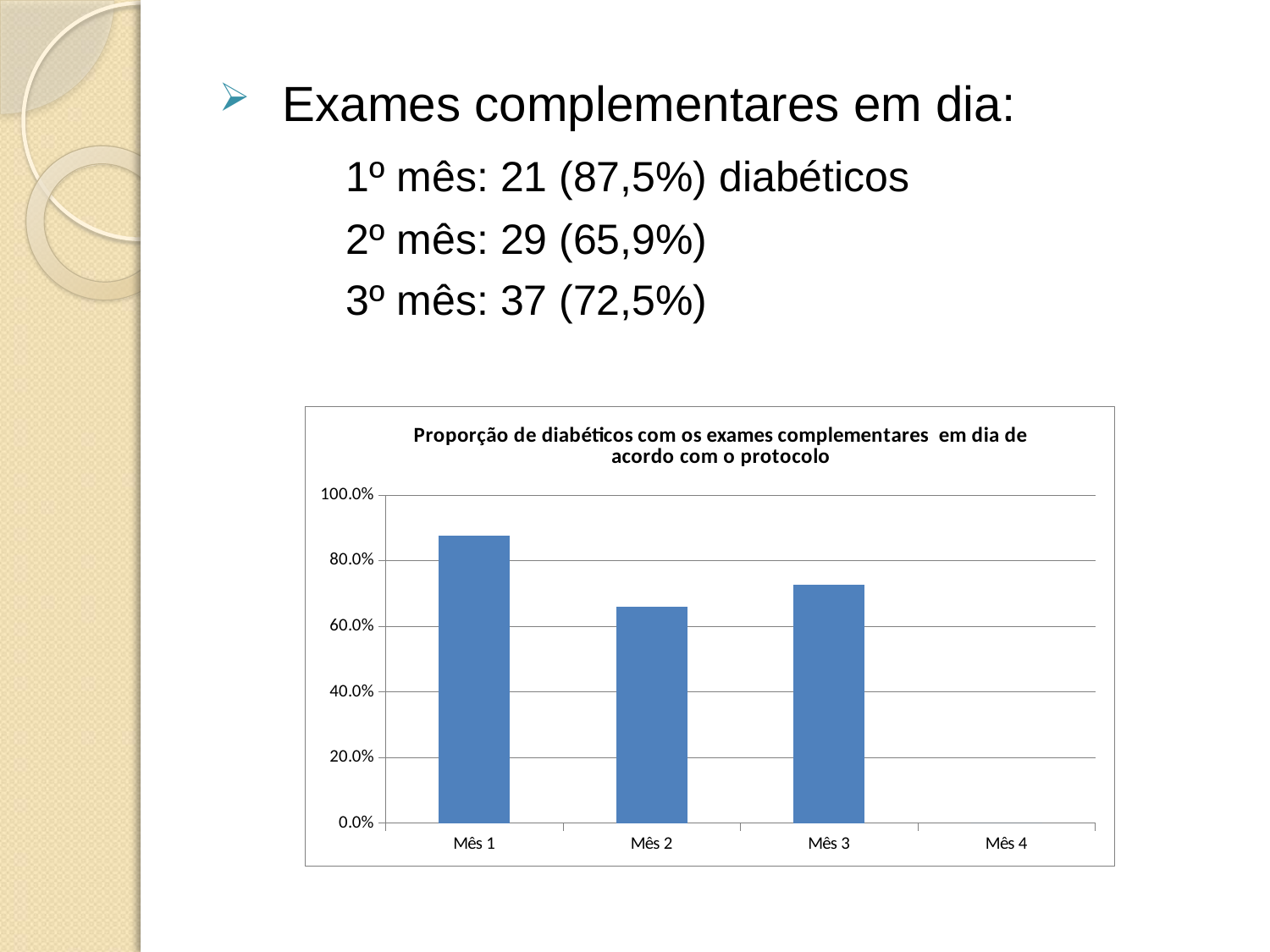
Does the value rise or fall from Mês 1 to Mês 2? fall How many bars are plotted in the chart? 3 What is the title of the chart? Proporção de diabéticos com os exames complementares em dia de acordo com o protocolo What kind of chart is shown on the slide? bar chart Which is larger, the value for Mês 2 or the value for Mês 3? Mês 3 Which month has the highest bar in the chart? Mês 1 Is the value for Mês 1 greater or less than 80.0%? greater Which x-axis category has no bar plotted? Mês 4 Is the value for Mês 3 greater or less than 60.0%? greater Is the value for Mês 2 greater or less than 80.0%? less How many categories are labelled on the x axis of the chart? 4 Among the months with a plotted bar, which has the lowest value? Mês 2